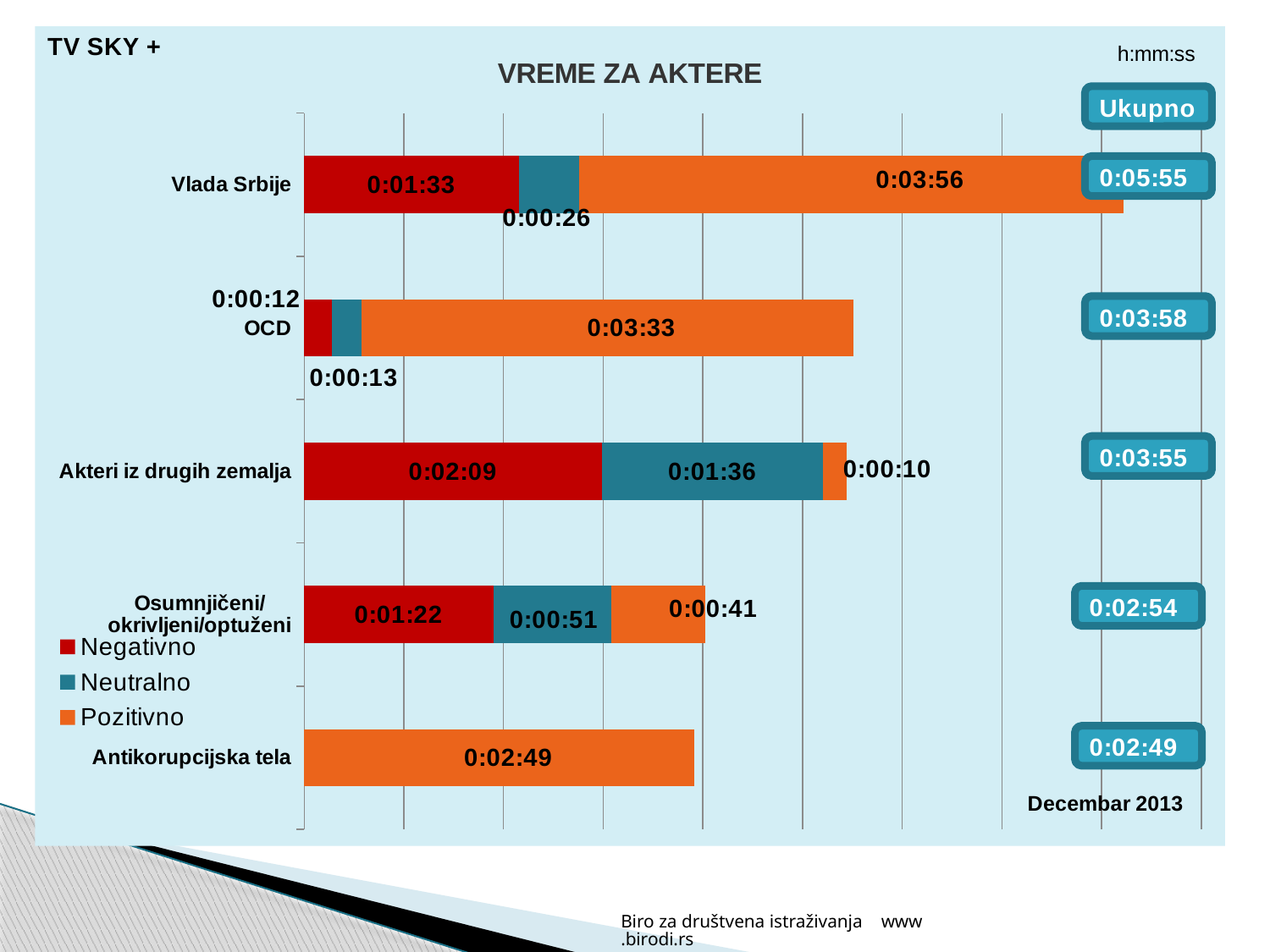
Which category has the highest Ukupno (total) value? Vlada Srbije How many series does the legend list? 3 What is the difference between the Pozitivno value for Vlada Srbije and the Pozitivno value for OCD? 0:00:23 What is the Pozitivno value for Vlada Srbije? 0:03:56 What is the Neutralno value for Osumnjičeni/okrivljeni/optuženi? 0:00:51 What is the Negativno value for Akteri iz drugih zemalja? 0:02:09 What type of chart is shown on the slide? Stacked bar chart What is the title of the chart? VREME ZA AKTERE How many categories (actors) are shown on the chart? 5 What is the Ukupno (total) value for OCD? 0:03:58 Which is larger for Akteri iz drugih zemalja: the Negativno value or the Neutralno value? Negativno Which category has the lowest Ukupno (total) value? Antikorupcijska tela